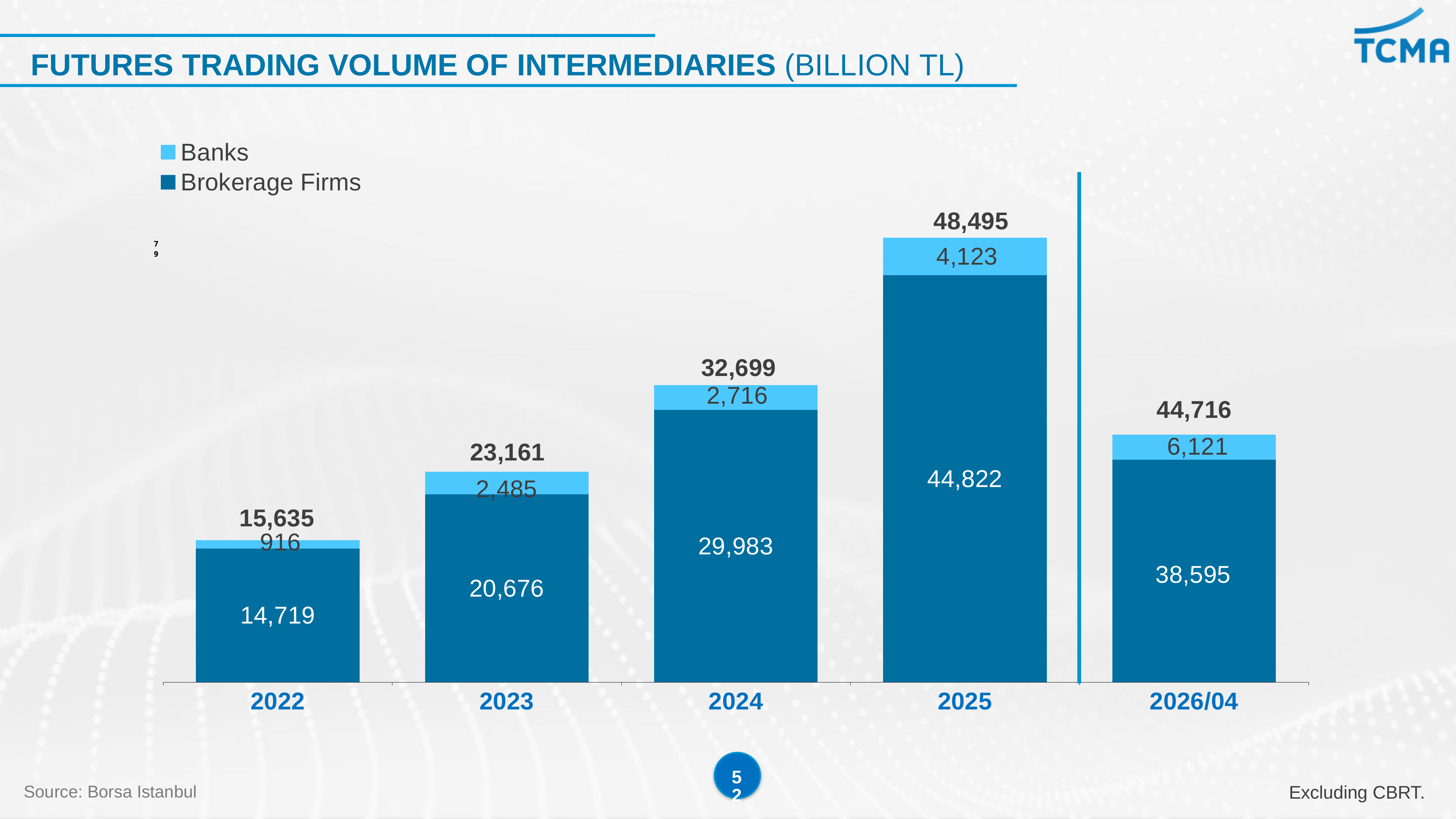
What is the difference between the Banks values for 2026/04 and 2025? 1,998 What is the Banks value for 2022? 916 Which is larger, the Banks value for 2023 or the Banks value for 2024? 2024 What is the Brokerage Firms value for 2024? 29,983 Which year has the highest total futures trading volume? 2025 How many periods are shown on the x axis? 5 Which year has the lowest Brokerage Firms value? 2022 What is the Banks value for 2026/04? 6,121 How many series does the legend list? 2 What kind of chart is shown on the slide? Stacked bar chart What is the difference between the Brokerage Firms values for 2025 and 2024? 14,839 What is the total futures trading volume shown for 2025? 48,495